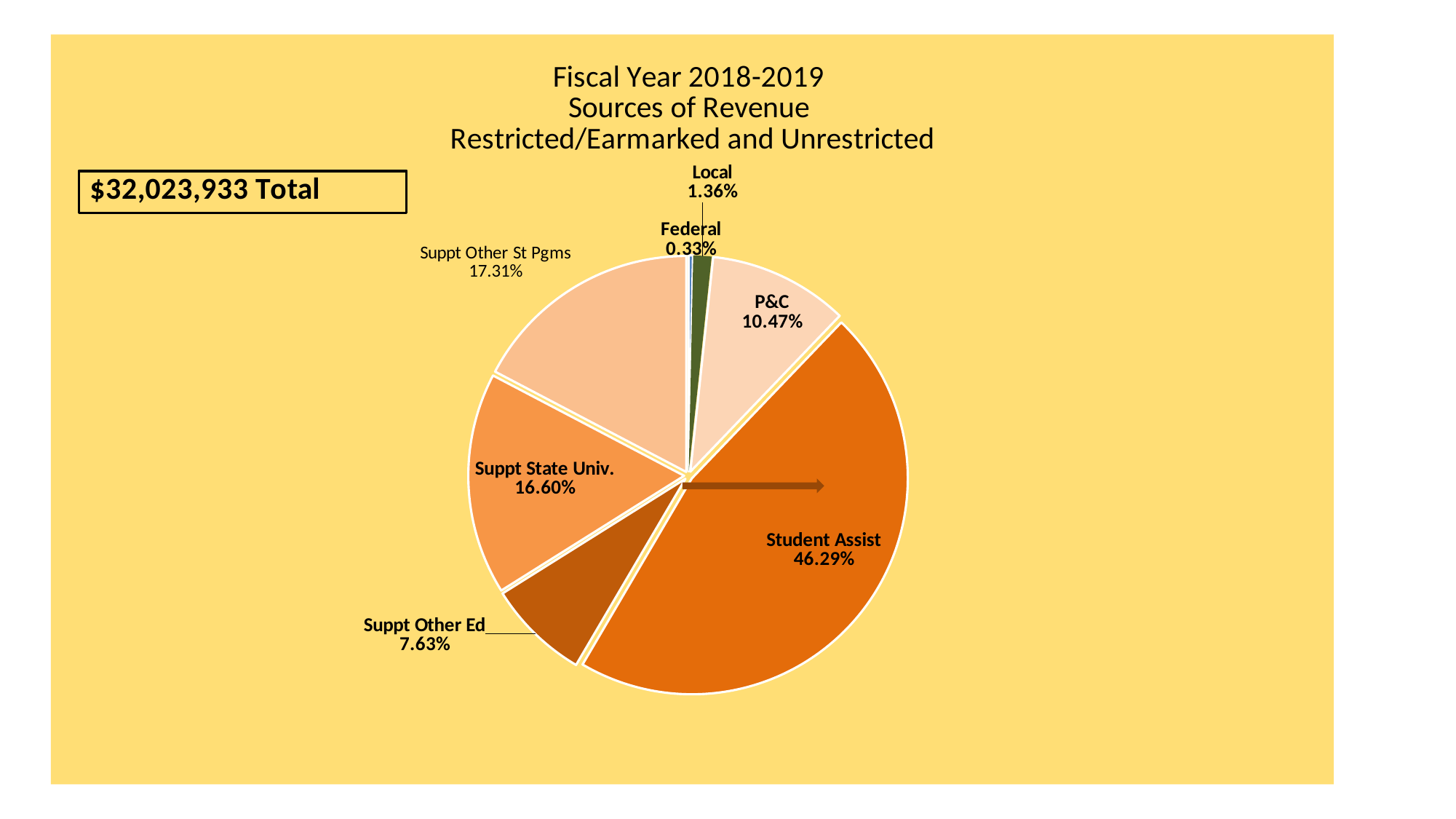
Which source of revenue has the largest share? Student Assist What is the difference in percentage points between the Suppt Other St Pgms share and the Suppt State Univ. share? 0.71 What total revenue amount is shown in the box on the slide? $32,023,933 Which source of revenue has the smallest share? Federal What share of revenue does Suppt Other St Pgms represent? 17.31% What share of revenue does Federal represent? 0.33% What share of revenue does Student Assist represent? 46.29% How many slices does the pie chart have? 7 What kind of chart is shown on the slide? pie chart Which is larger, the share for Suppt Other Ed or the share for P&C? P&C